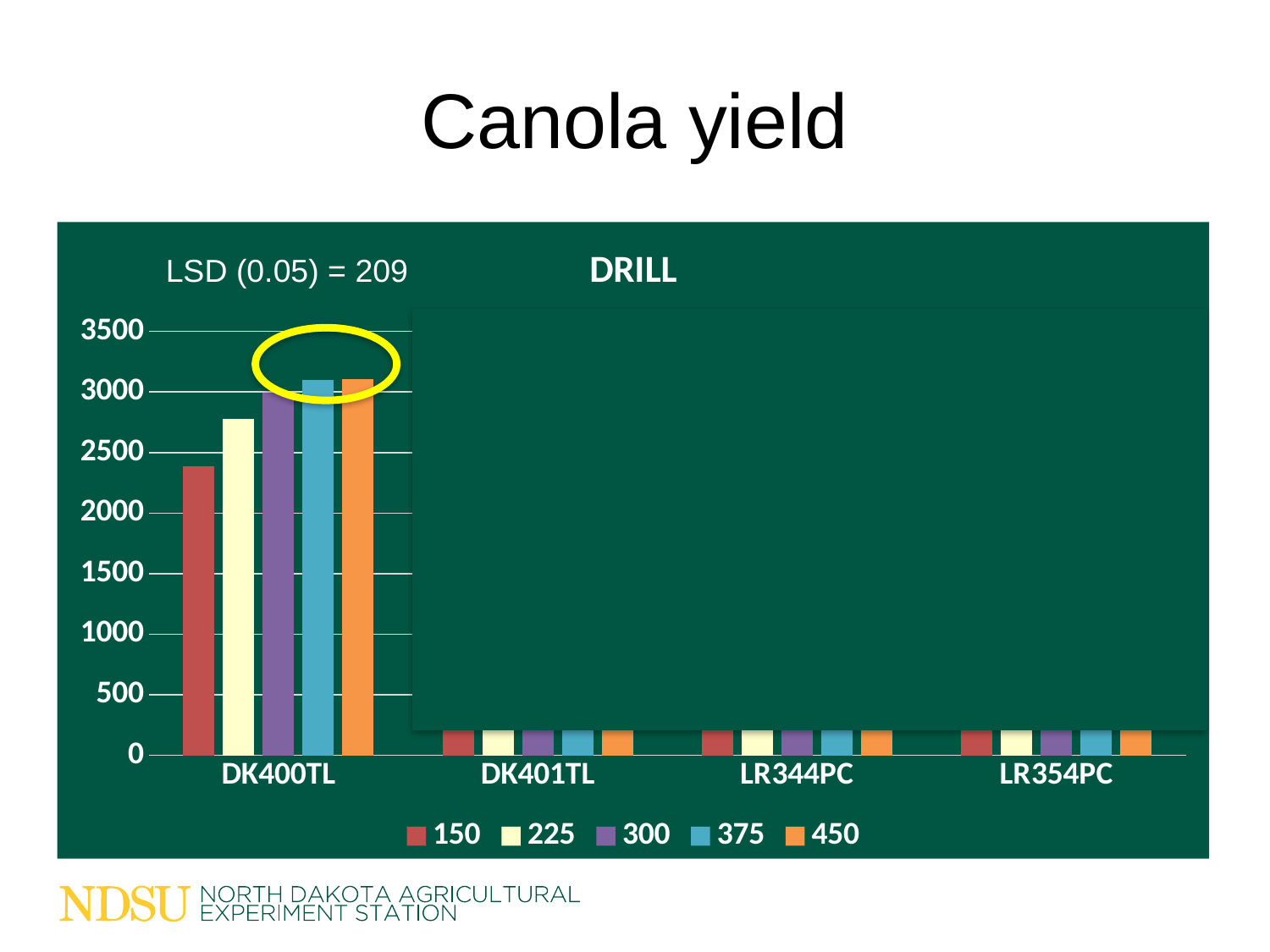
For DK400TL, which is larger: the value for 150 or the value for 225? 225 For DK400TL, which is larger: the value for 225 or the value for 300? 300 Is the value for 225 at DK400TL greater or less than 2500? greater Which series has the lowest value for DK400TL? 150 What LSD (0.05) value is printed on the chart? 209 What is the title shown above the chart area? DRILL How many categories are shown on the x axis? 4 Is the value for 375 at DK400TL greater or less than 3000? greater How many series does the legend list? 5 What kind of chart is shown on the slide? bar chart Is the value for 450 at DK400TL greater or less than 3500? less